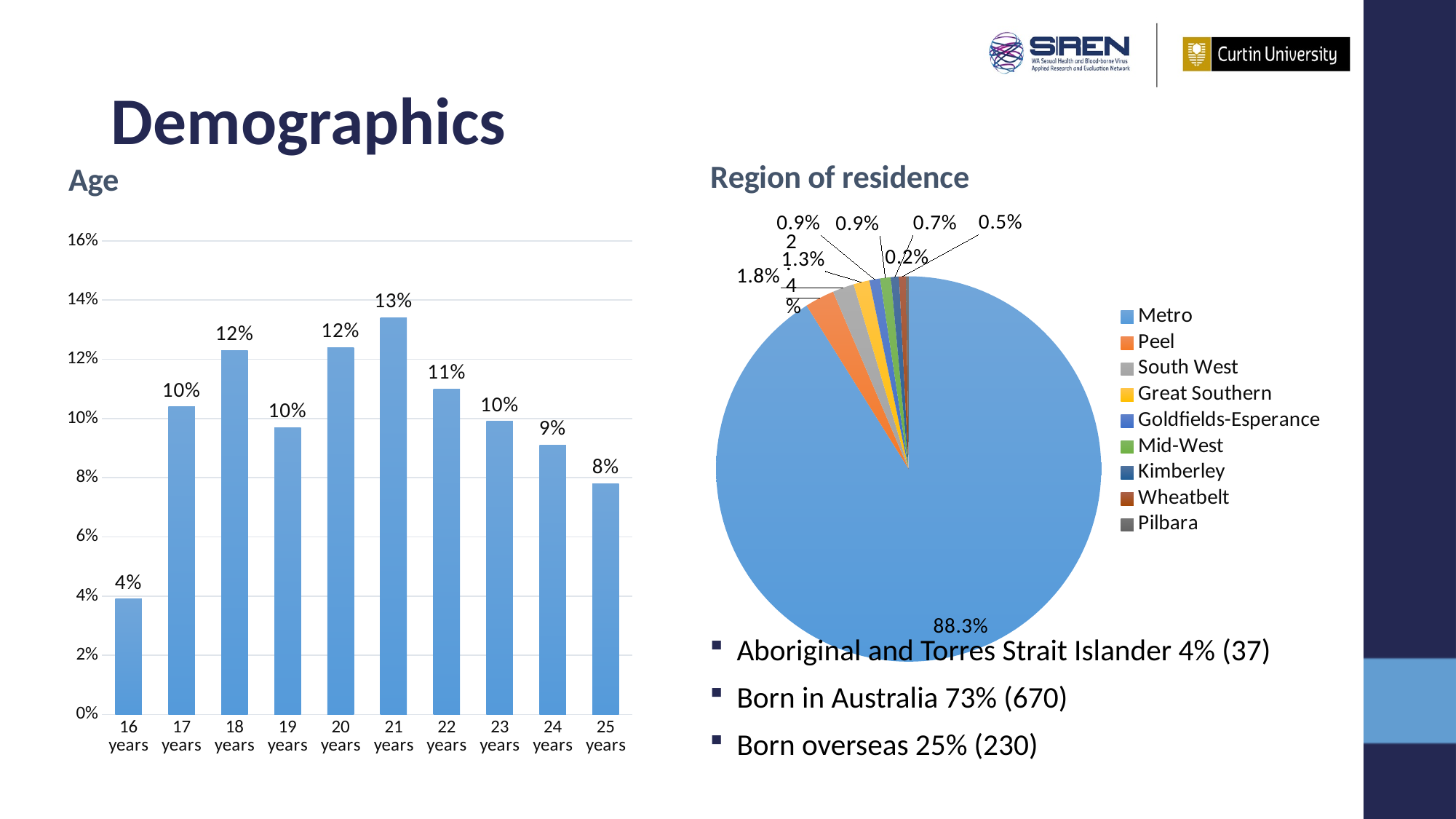
On the Region of residence pie chart, what share does Metro have? 88.3% How many regions does the legend of the Region of residence pie chart list? 9 What kind of chart is the Age chart? Bar chart On the Age chart, what is the difference between the percentages for 21 years and 16 years? 9 percentage points On the Age chart, what percentage is shown for 16 years? 4% On the Age chart, do the values rise or fall from 21 years to 25 years? Fall How many age groups are shown on the Age chart? 10 On the Age chart, what percentage is shown for 25 years? 8% On the Age chart, which age group has the highest percentage? 21 years On the Age chart, which age group has the lowest percentage? 16 years On the Age chart, which is larger, the value for 18 years or the value for 19 years? 18 years On the Age chart, what percentage is shown for 21 years? 13%